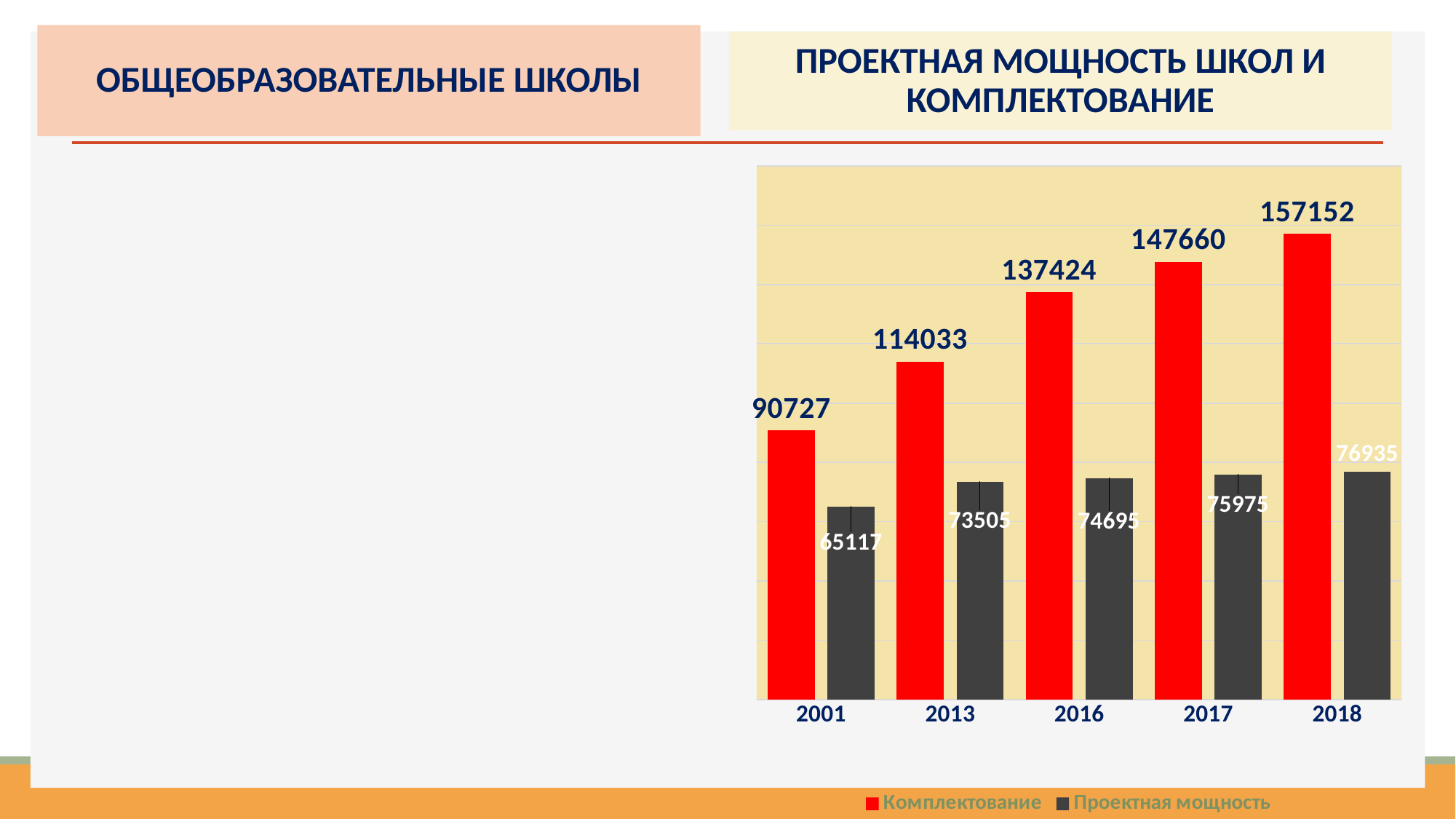
What kind of chart is shown on the slide? Bar chart Which year has the lowest Проектная мощность value? 2001 How many series does the legend list? 2 Does the Комплектование value rise or fall from 2001 to 2018? Rise Which is larger in 2013: Комплектование or Проектная мощность? Комплектование Which year has the highest Комплектование value? 2018 What is the difference between Комплектование and Проектная мощность in 2018? 80217 What is the value of Проектная мощность for 2017? 75975 What is the value of Комплектование for 2018? 157152 What is the value of Комплектование for 2016? 137424 What is the value of Проектная мощность for 2001? 65117 How many years are shown on the x axis? 5